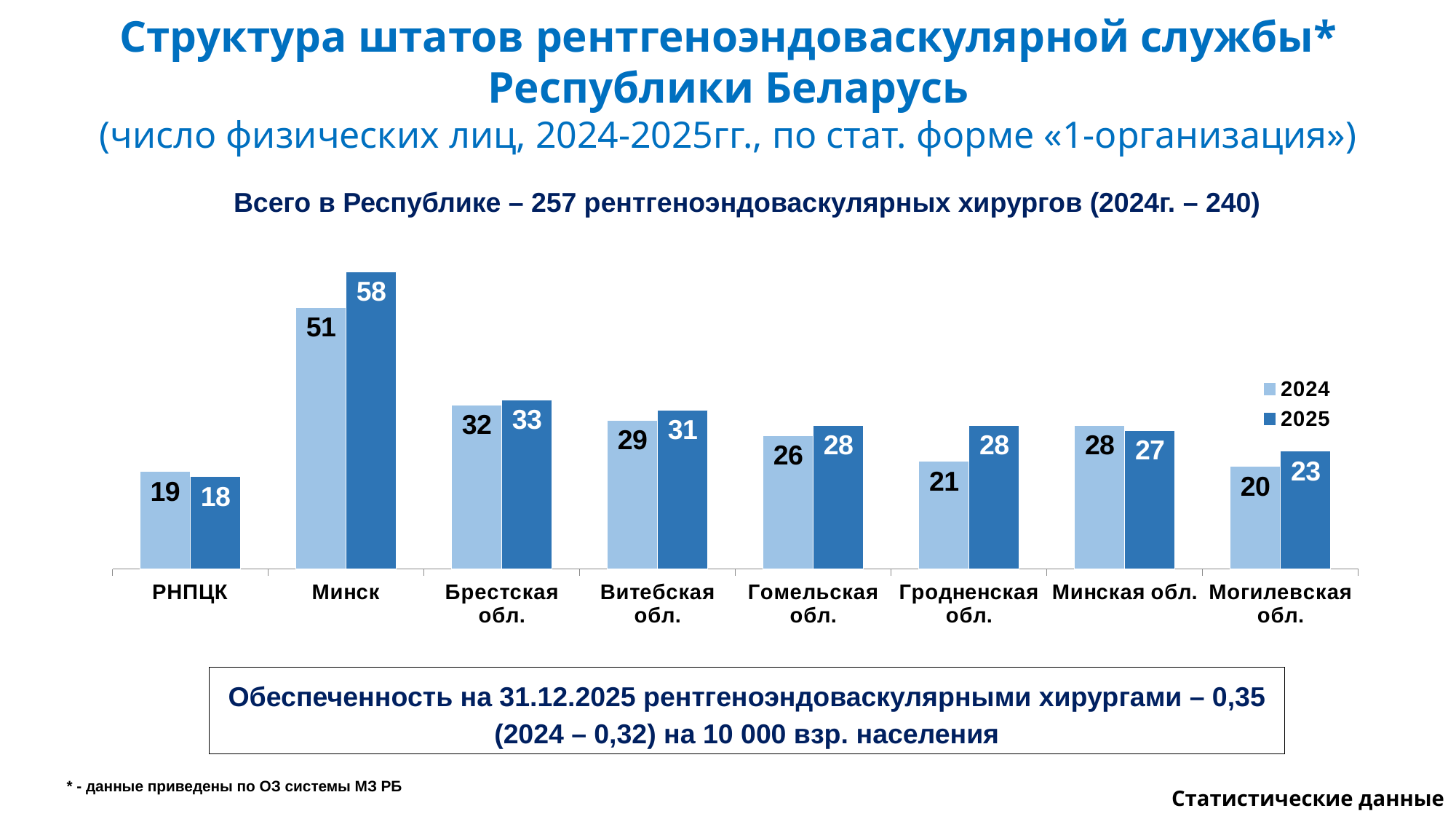
Which is larger, the 2025 value for Брестская обл. or the 2025 value for Витебская обл.? Брестская обл. What is the difference between the 2025 and 2024 values for Гродненская обл.? 7 What is the 2024 value for Гомельская обл.? 26 What is the 2025 value for Могилевская обл.? 23 What are the two series named in the legend? 2024 and 2025 How many series does the legend list? 2 What is the 2025 value for Минск? 58 How many categories are shown on the x axis? 8 What kind of chart is shown on the slide? bar chart Which category has the highest 2025 value? Минск Which is larger for Минская обл., the 2024 value or the 2025 value? 2024 Which category has the lowest 2024 value? РНПЦК